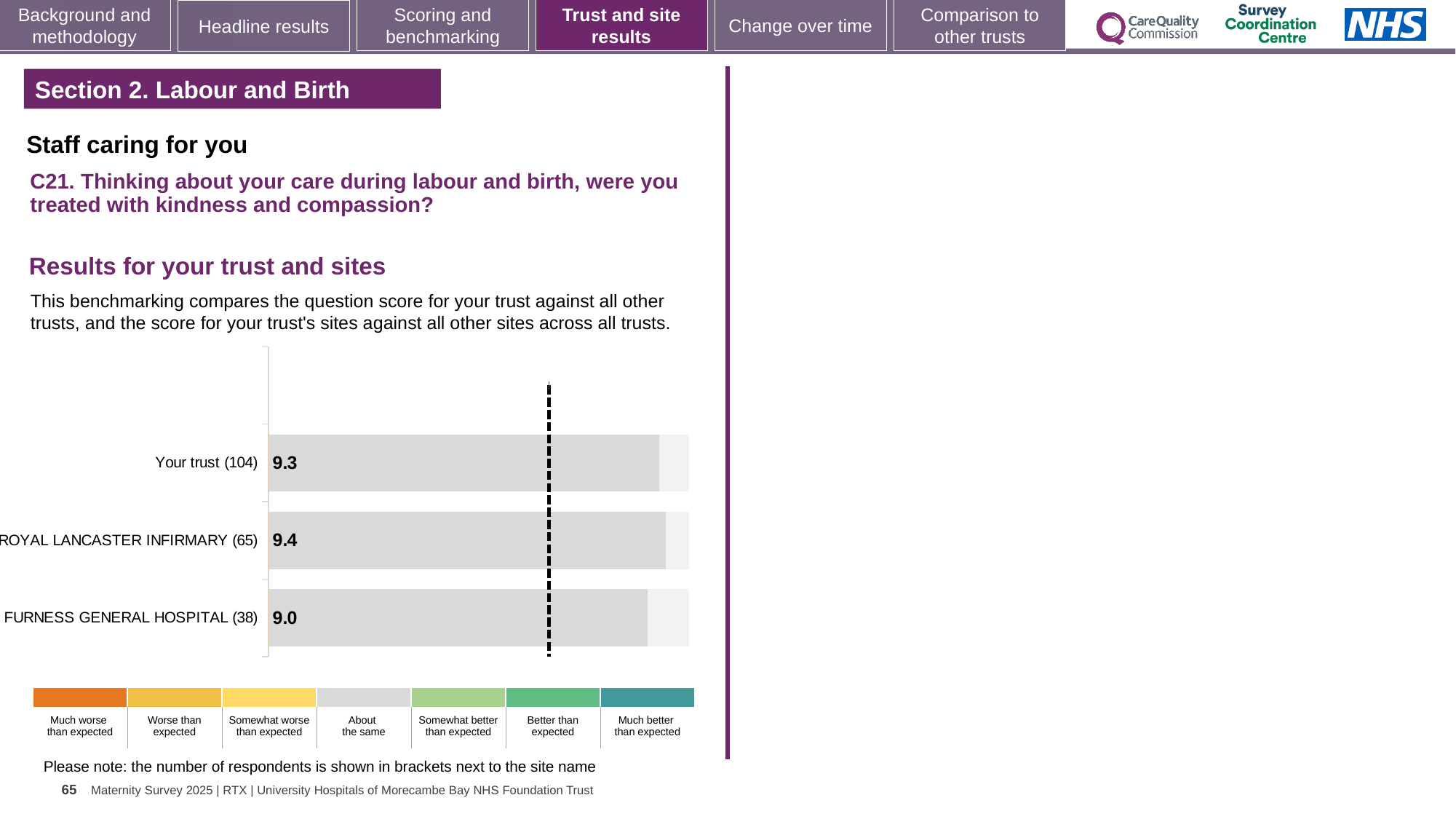
Which site or trust has the highest score? ROYAL LANCASTER INFIRMARY What is the difference between the scores for Your trust and FURNESS GENERAL HOSPITAL? 0.3 Which has a higher score, Your trust or ROYAL LANCASTER INFIRMARY? ROYAL LANCASTER INFIRMARY Which site or trust has the lowest score? FURNESS GENERAL HOSPITAL How many categories does the colour legend below the chart list? 7 What is the difference between the scores for ROYAL LANCASTER INFIRMARY and FURNESS GENERAL HOSPITAL? 0.4 How many bars are shown in the chart? 3 What is the score for FURNESS GENERAL HOSPITAL? 9.0 What is the score for ROYAL LANCASTER INFIRMARY? 9.4 How many respondents are shown in brackets for FURNESS GENERAL HOSPITAL? 38 What is the score for Your trust? 9.3 What kind of chart is shown on the slide? Bar chart